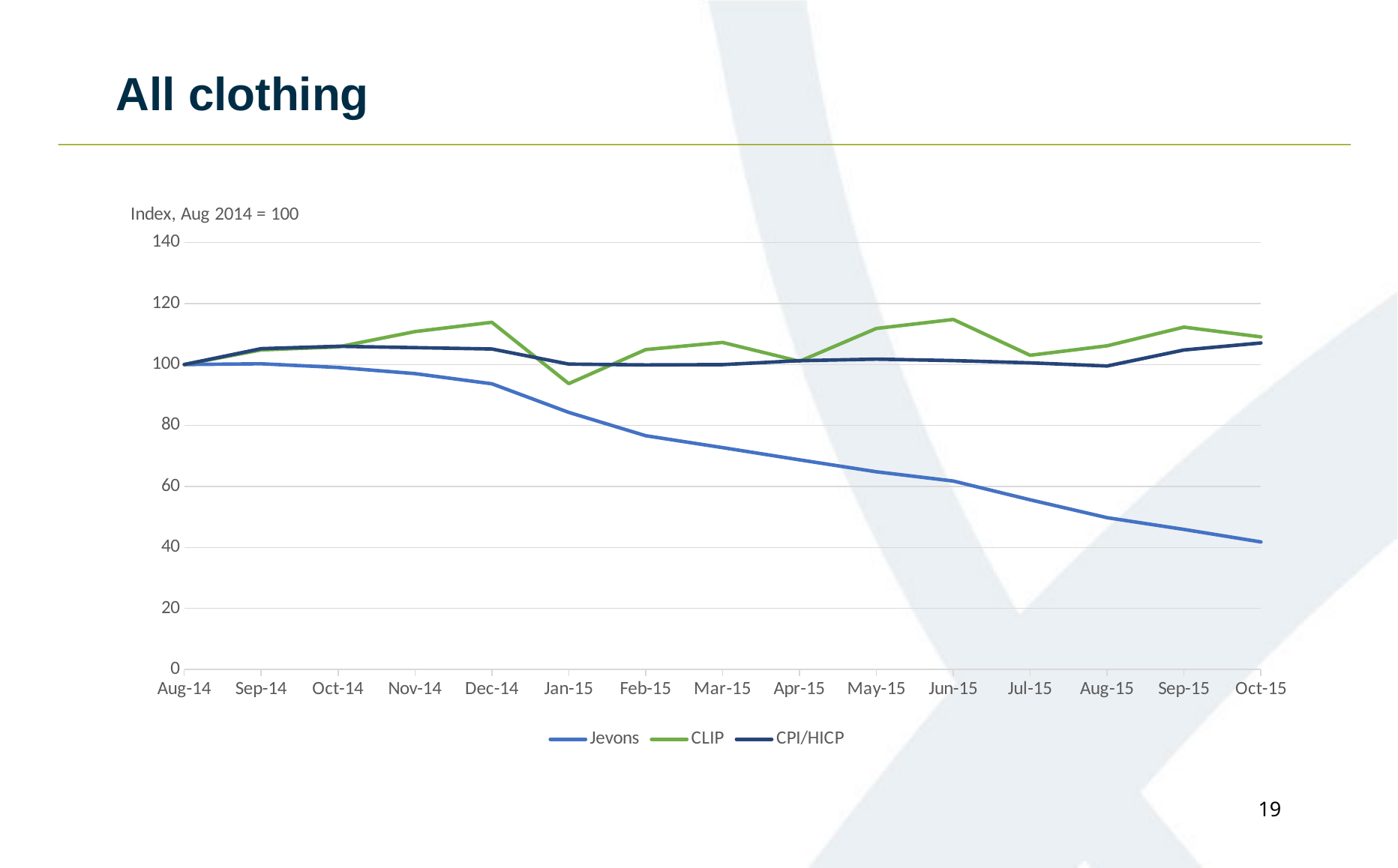
At Oct-15, which is larger, CLIP or Jevons? CLIP Is the value for CLIP at Jan-15 greater or less than 100? less Which series has the lowest value at Oct-15? Jevons How many series does the legend list? 3 Is the value for CLIP at Jun-15 greater or less than 100? greater What is the value of the Jevons series at Aug-14? 100 Is the value for Jevons at Jan-15 greater or less than 100? less What kind of chart is shown on the slide? line chart Does the Jevons series rise or fall from Aug-14 to Oct-15? fall How many months are plotted along the x axis? 15 What is the title of the slide containing the chart? All clothing